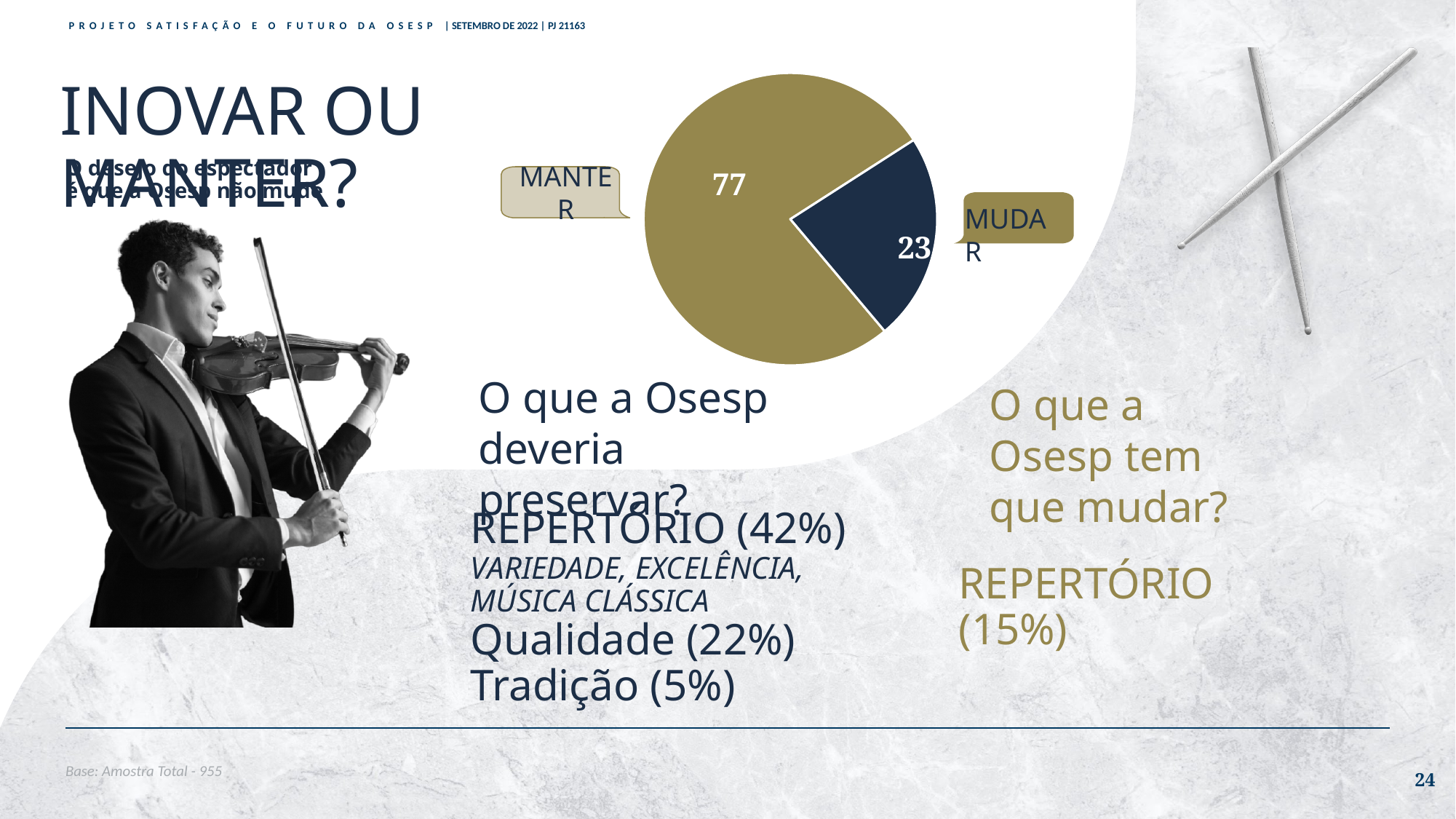
Which slice of the pie chart is the largest? MANTER What is the value shown for the MANTER slice of the pie chart? 77 Which is larger in the pie chart, MANTER or MUDAR? MANTER Which slice of the pie chart is the smallest? MUDAR What is the total of the two values shown in the pie chart? 100 How many slices does the pie chart have? 2 What kind of chart is shown on the slide? pie chart What is the value shown for the MUDAR slice of the pie chart? 23 What is the difference between the MANTER and MUDAR values in the pie chart? 54 What colour is the MANTER slice of the pie chart? gold What colour is the MUDAR slice of the pie chart? dark navy blue